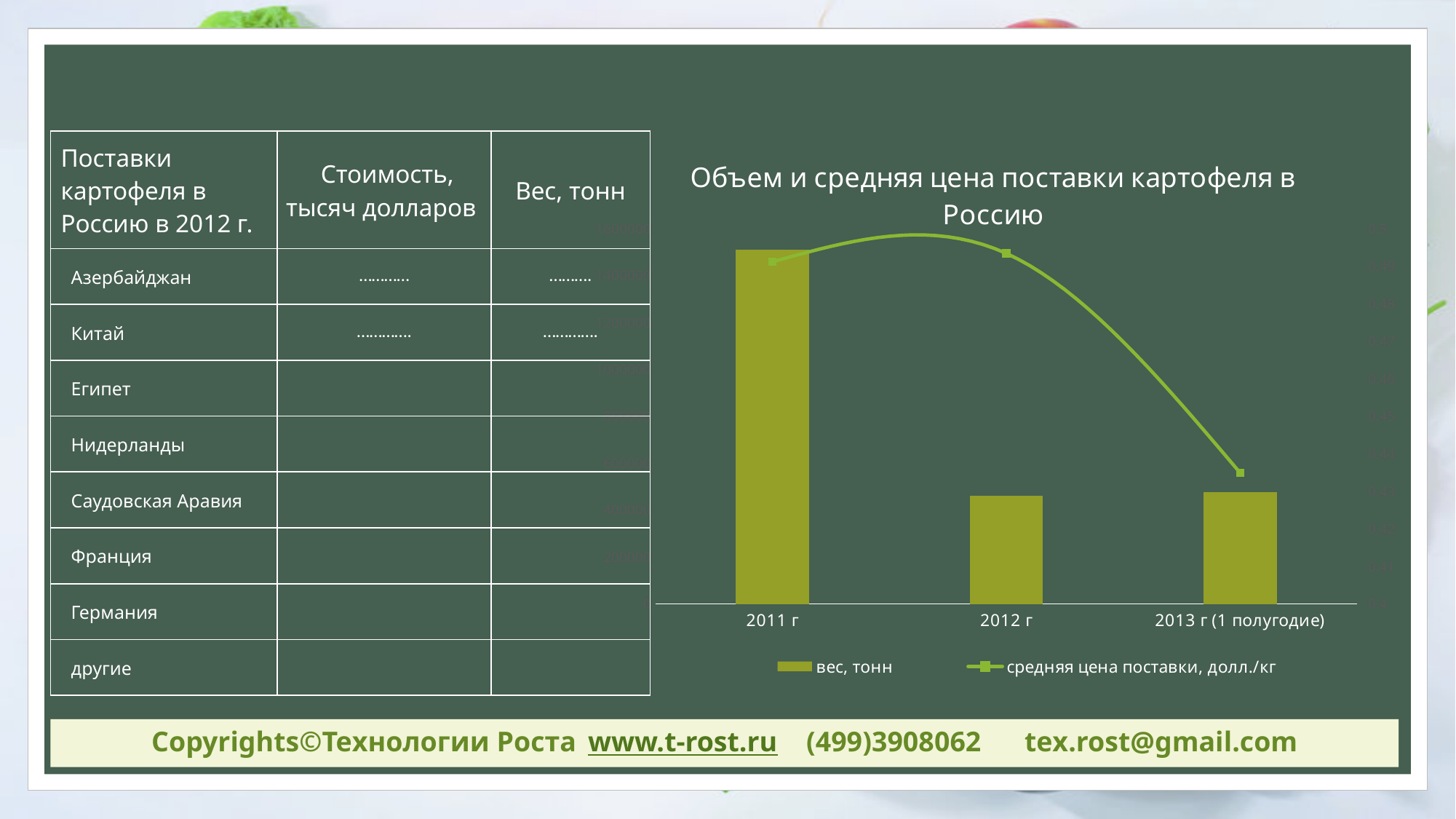
What is the title of the chart? Объем и средняя цена поставки картофеля в Россию Does the средняя цена поставки, долл./кг line rise or fall from 2012 г to 2013 г (1 полугодие)? Fall How many series does the chart legend list? 2 What kind of chart is shown on the slide? A combined bar and line chart Is the средняя цена поставки, долл./кг value higher in 2011 г or in 2013 г (1 полугодие)? 2011 г Which category has the lowest point on the средняя цена поставки, долл./кг line? 2013 г (1 полугодие) Does the вес, тонн bar rise or fall from 2011 г to 2012 г? Fall Which category has the tallest bar for вес, тонн? 2011 г Which series in the chart is drawn as a line? средняя цена поставки, долл./кг What is the label of the third category on the x axis? 2013 г (1 полугодие) How many categories are shown on the x axis of the chart? 3 Is the bar for вес, тонн larger in 2011 г or in 2012 г? 2011 г